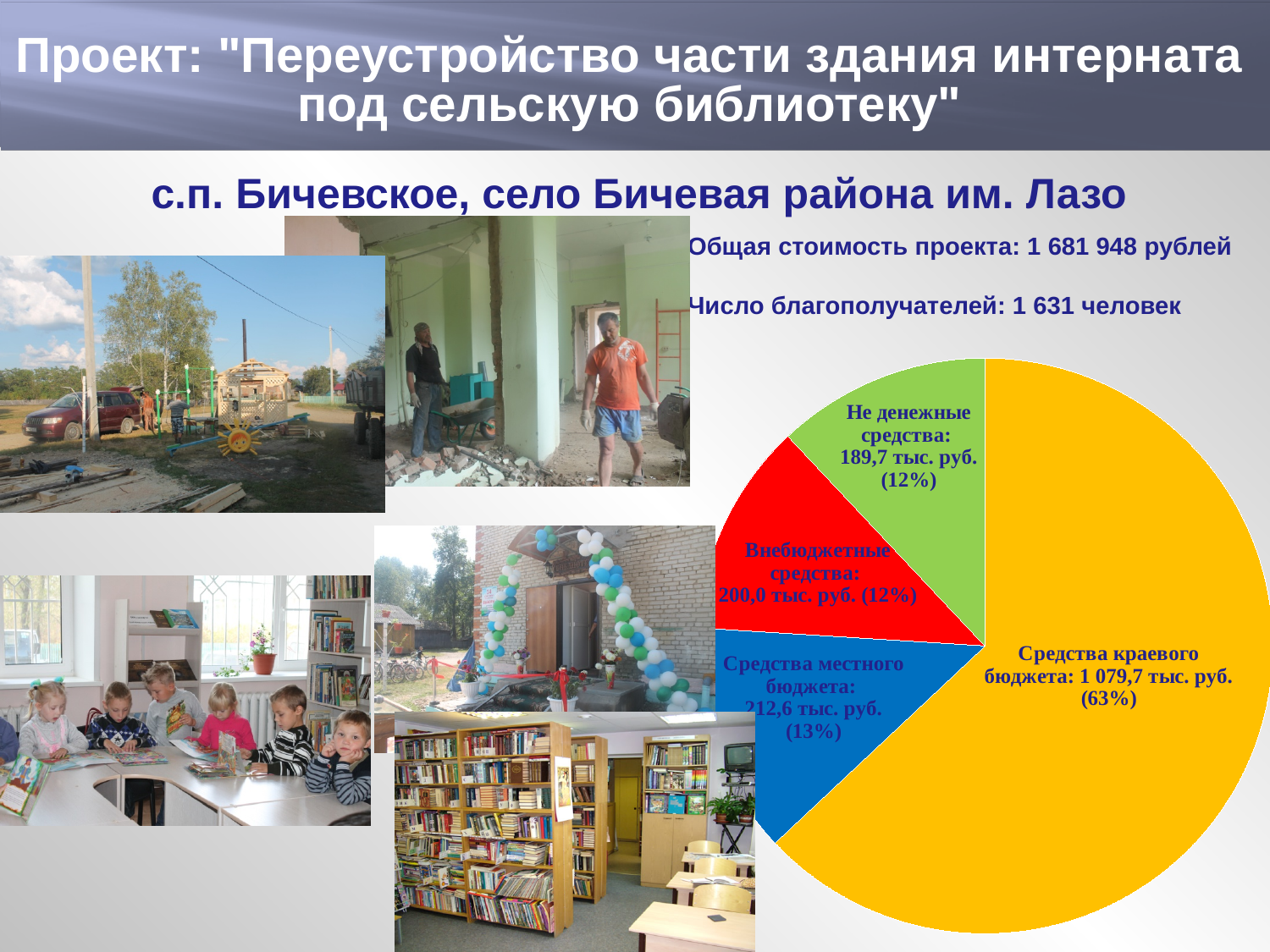
Which colour is used for the Средства краевого бюджета slice? yellow What is the value shown for Внебюджетные средства? 200,0 тыс. руб. What is the difference between Средства краевого бюджета and Средства местного бюджета? 867,1 тыс. руб. What share of the pie does Средства местного бюджета take? 13% What is the value shown for Средства краевого бюджета? 1 079,7 тыс. руб. What is the value shown for Средства местного бюджета? 212,6 тыс. руб. What kind of chart is shown on the slide? pie chart Which slice of the pie chart is the largest? Средства краевого бюджета What share of the pie does Средства краевого бюджета take? 63% What is the value shown for Не денежные средства? 189,7 тыс. руб. How many slices does the pie chart have? 4 Which slice of the pie chart is the smallest? Не денежные средства